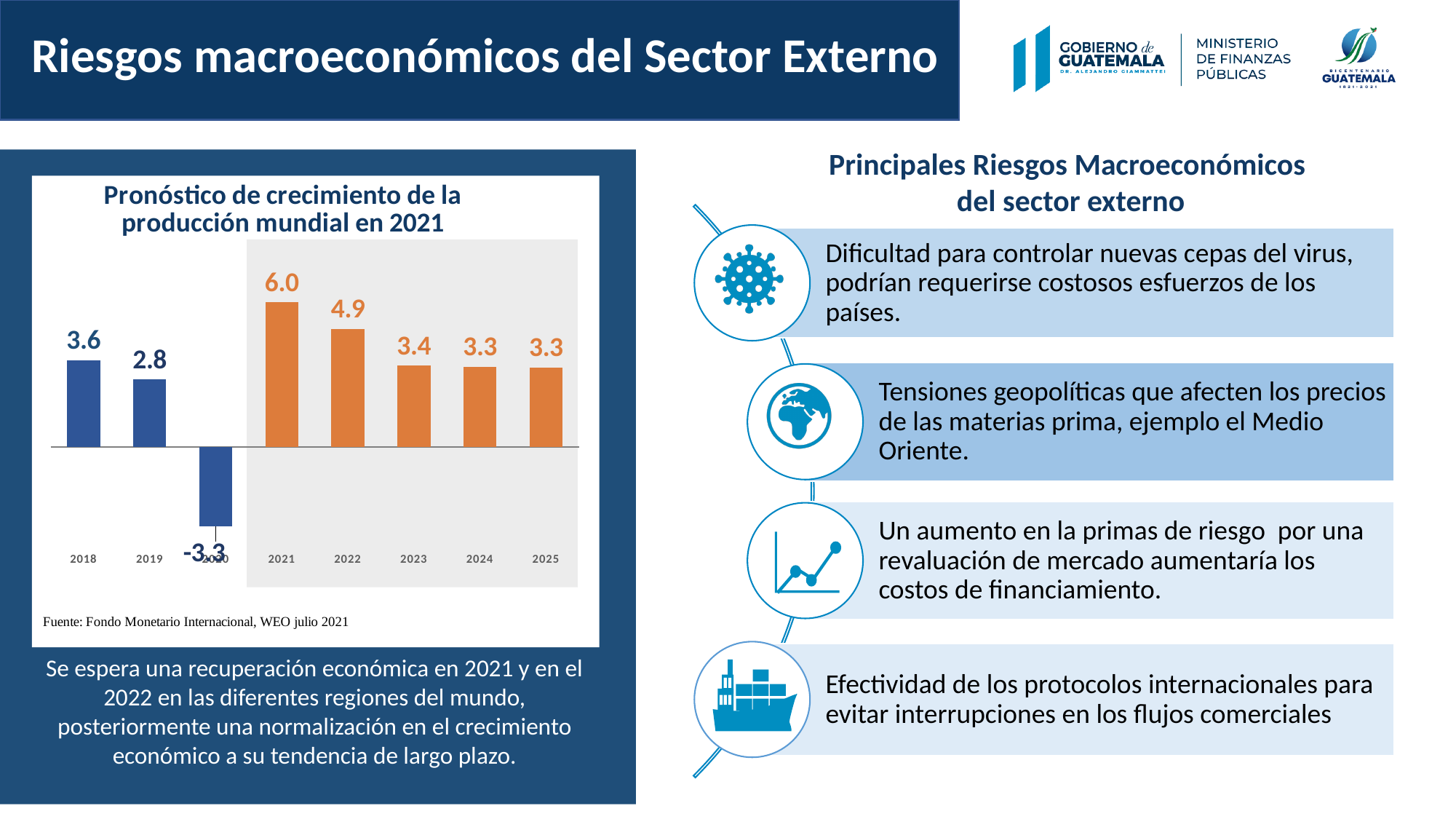
Do the values rise or fall from 2021 to 2025? Fall Which is larger, the value for 2018 or the value for 2019? 2018 What is the title of the chart? Pronóstico de crecimiento de la producción mundial en 2021 What is the value for 2020 in the chart? -3.3 What is the value for 2018 in the chart? 3.6 Which year has the lowest value in the chart? 2020 Which year has the highest value in the chart? 2021 What kind of chart is shown on the slide? Bar chart How many years are shown in the chart? 8 What is the value for 2021 in the chart? 6.0 What is the difference between the values for 2021 and 2022? 1.1 What is the value for 2022 in the chart? 4.9